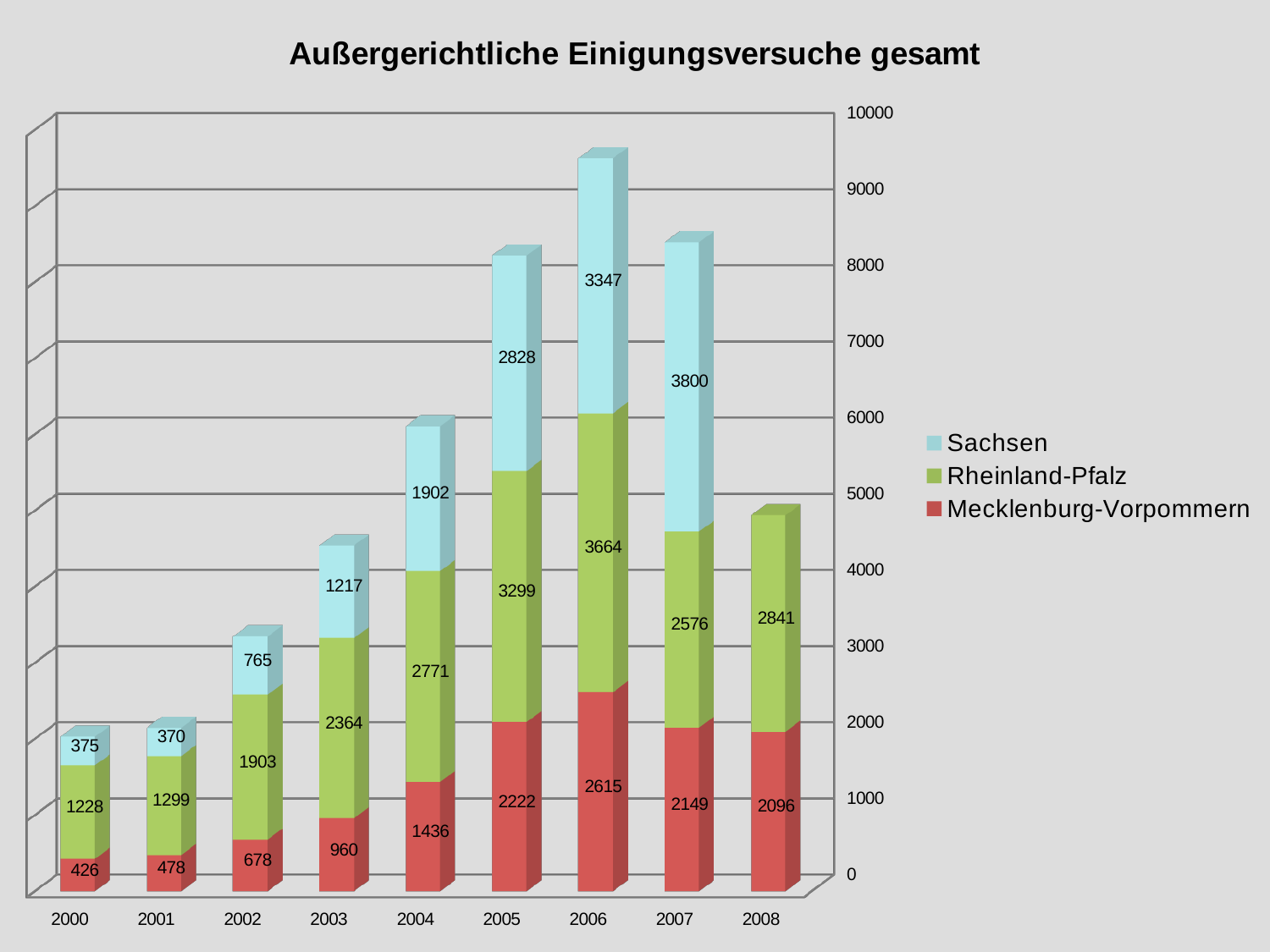
Which is larger, the Rheinland-Pfalz value in 2005 or in 2007? 2005 What is the title of the chart? Außergerichtliche Einigungsversuche gesamt How many years are shown on the x axis? 9 What is the value for Sachsen in 2003? 1217 In which year is the Mecklenburg-Vorpommern value lowest? 2000 What is the value for Rheinland-Pfalz in 2008? 2841 What is the total of the stacked bar for 2006? 9626 What is the value for Mecklenburg-Vorpommern in 2004? 1436 What kind of chart is shown on the slide? Stacked bar chart What is the difference between the Sachsen values for 2007 and 2006? 453 In which year is the Sachsen value highest? 2007 How many series does the legend list? 3